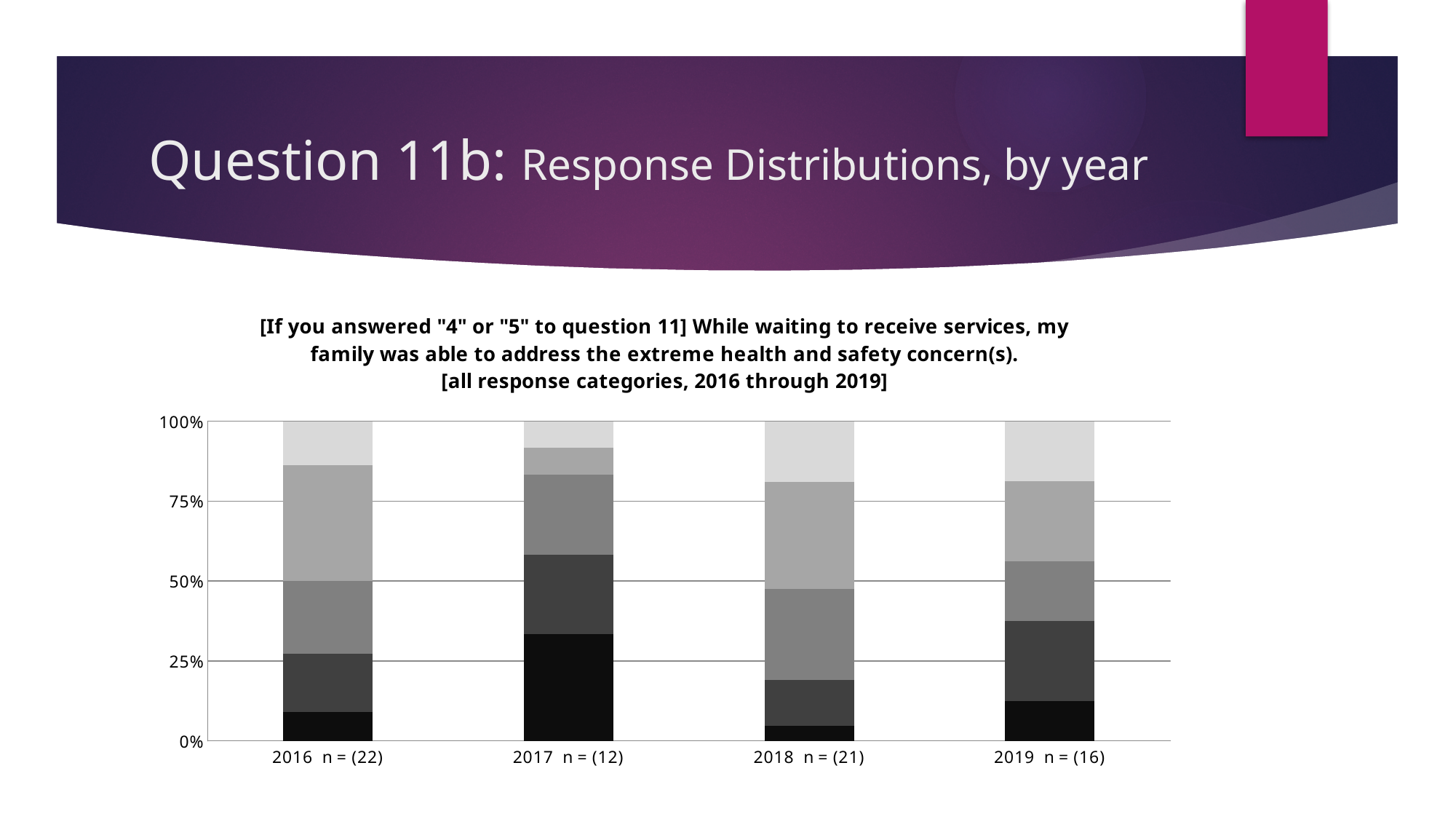
Which year's bar has the largest bottom (black) segment? 2017 How many years (bars) are shown on the x axis of the chart? 4 What range of years does the chart title say the response categories cover? 2016 through 2019 What is the sample size (n) shown for 2017 in the chart? 12 Which year's bar has the smallest top (lightest grey) segment? 2017 What kind of chart is shown on the slide? Stacked bar chart What is the sample size (n) shown for 2016 in the chart? 22 Which year has the largest sample size (n) in the chart? 2016 Is the bottom (black) segment of the 2017 bar greater or less than 25%? greater Is the bottom (black) segment of the 2016 bar greater or less than 25%? less Which year has the smallest sample size (n) in the chart? 2017 What is the total height of each stacked bar in the chart? 100%